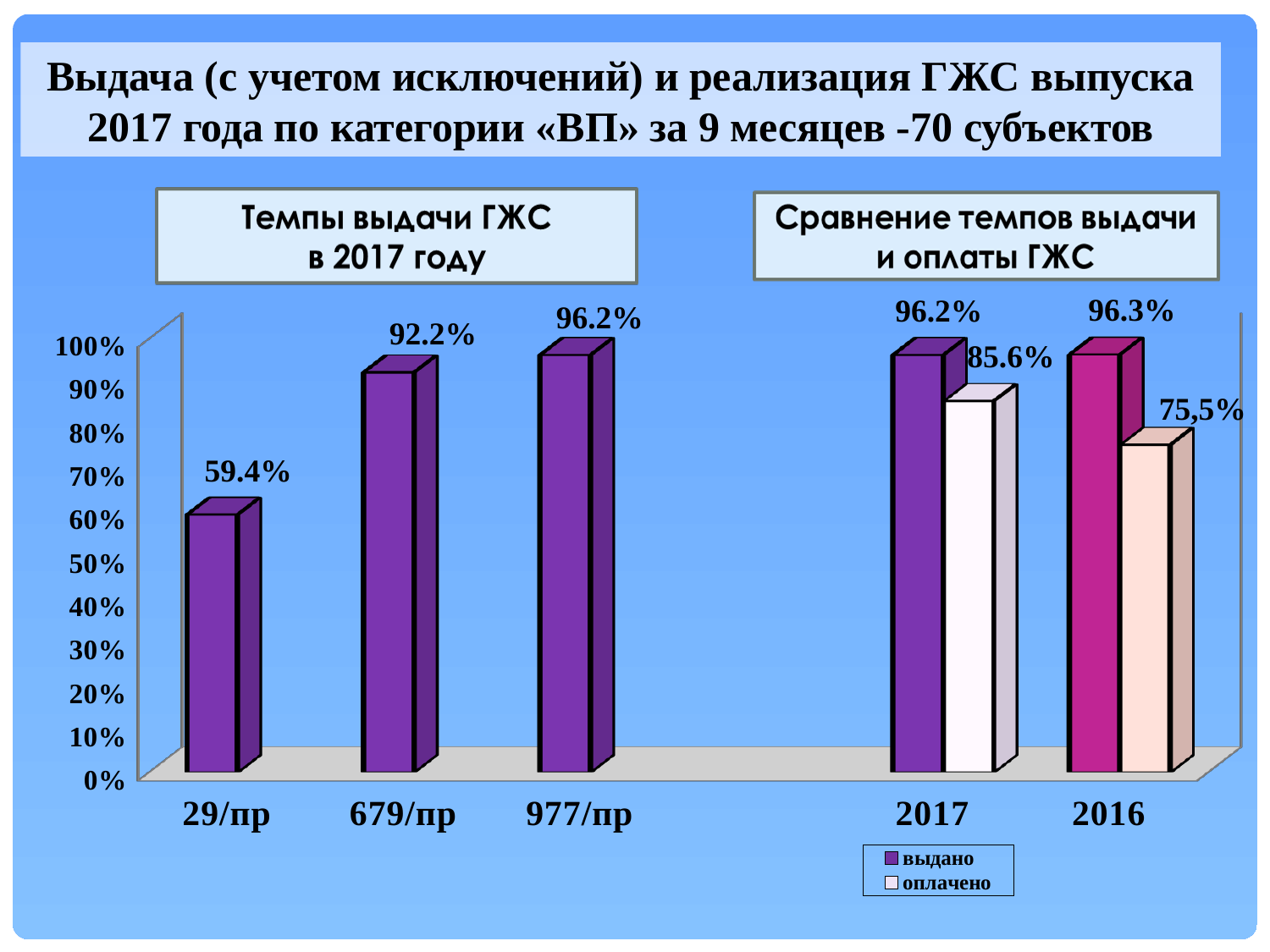
In the chart 'Темпы выдачи ГЖС в 2017 году', how many categories are shown? 3 In the chart 'Темпы выдачи ГЖС в 2017 году', what is the difference between the values for 977/пр and 29/пр? 36.8% In the chart 'Темпы выдачи ГЖС в 2017 году', which category has the highest value? 977/пр In the chart 'Темпы выдачи ГЖС в 2017 году', what is the value for 29/пр? 59.4% In the chart 'Сравнение темпов выдачи и оплаты ГЖС', how many series does the legend list? 2 In the chart 'Сравнение темпов выдачи и оплаты ГЖС', what is the 'оплачено' value for 2017? 85.6% In the chart 'Сравнение темпов выдачи и оплаты ГЖС', what is the difference between 'выдано' and 'оплачено' for 2017? 10.6% What type of chart is the chart 'Сравнение темпов выдачи и оплаты ГЖС'? bar chart In the chart 'Темпы выдачи ГЖС в 2017 году', which category has the lowest value? 29/пр In the chart 'Темпы выдачи ГЖС в 2017 году', what is the value for 679/пр? 92.2% In the chart 'Темпы выдачи ГЖС в 2017 году', do the values rise or fall from 29/пр to 977/пр? rise In the chart 'Сравнение темпов выдачи и оплаты ГЖС', what is the 'оплачено' value for 2016? 75,5%